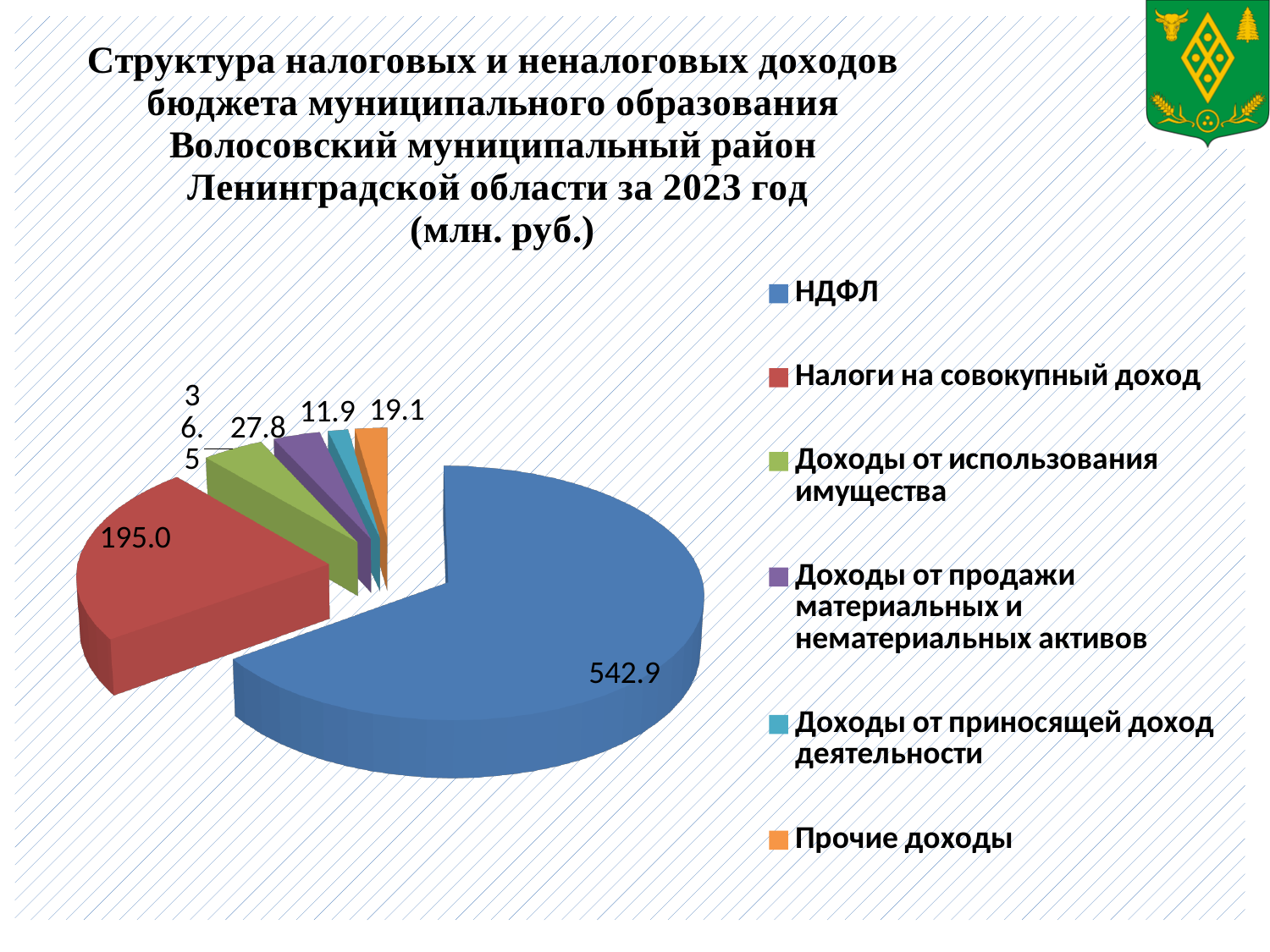
What colour is the НДФЛ slice? blue Which category has the largest slice of the pie? НДФЛ How many categories does the pie chart show? 6 What is the value for Прочие доходы? 19.1 What is the value for Налоги на совокупный доход? 195.0 What is the value for Доходы от приносящей доход деятельности? 11.9 What is the value for НДФЛ? 542.9 What is the value for Доходы от продажи материальных и нематериальных активов? 27.8 What is the difference between the values for НДФЛ and Налоги на совокупный доход? 347.9 What kind of chart is shown on the slide? pie chart Which category has the smallest slice of the pie? Доходы от приносящей доход деятельности Which is larger: Прочие доходы or Доходы от приносящей доход деятельности? Прочие доходы